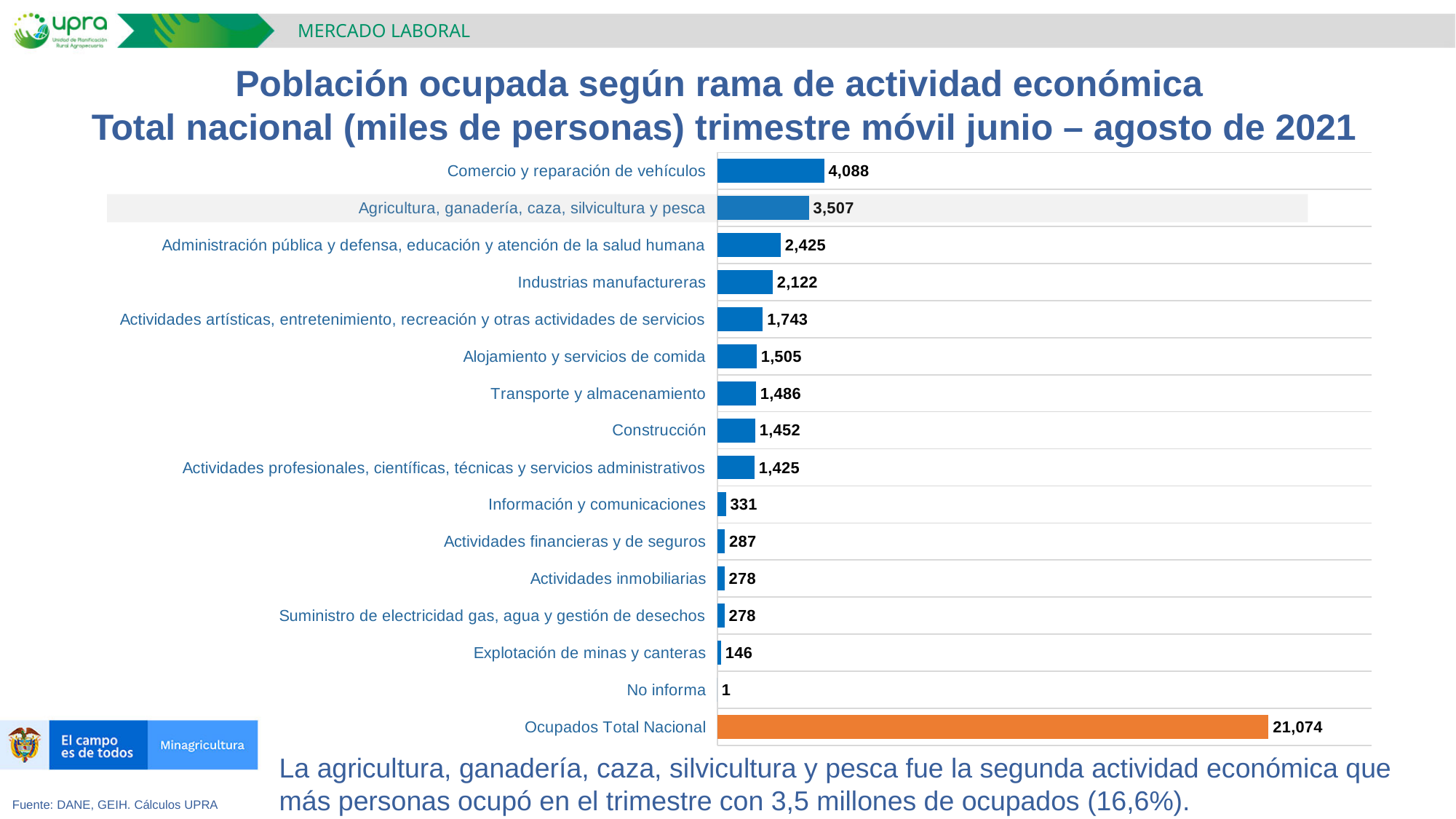
Excluding the Ocupados Total Nacional bar, which category has the highest value? Comercio y reparación de vehículos Which is larger, Transporte y almacenamiento or Construcción? Transporte y almacenamiento What is the difference between Administración pública y defensa, educación y atención de la salud humana and Industrias manufactureras? 303 What colour is the bar for Ocupados Total Nacional? Orange What is the value for Ocupados Total Nacional? 21,074 What kind of chart is shown on the slide? Bar chart What is the value for Agricultura, ganadería, caza, silvicultura y pesca? 3,507 How many categories are shown in the chart? 16 Which category has the lowest value? No informa What is the value for Explotación de minas y canteras? 146 What is the value for Comercio y reparación de vehículos? 4,088 What is the difference between Comercio y reparación de vehículos and Agricultura, ganadería, caza, silvicultura y pesca? 581